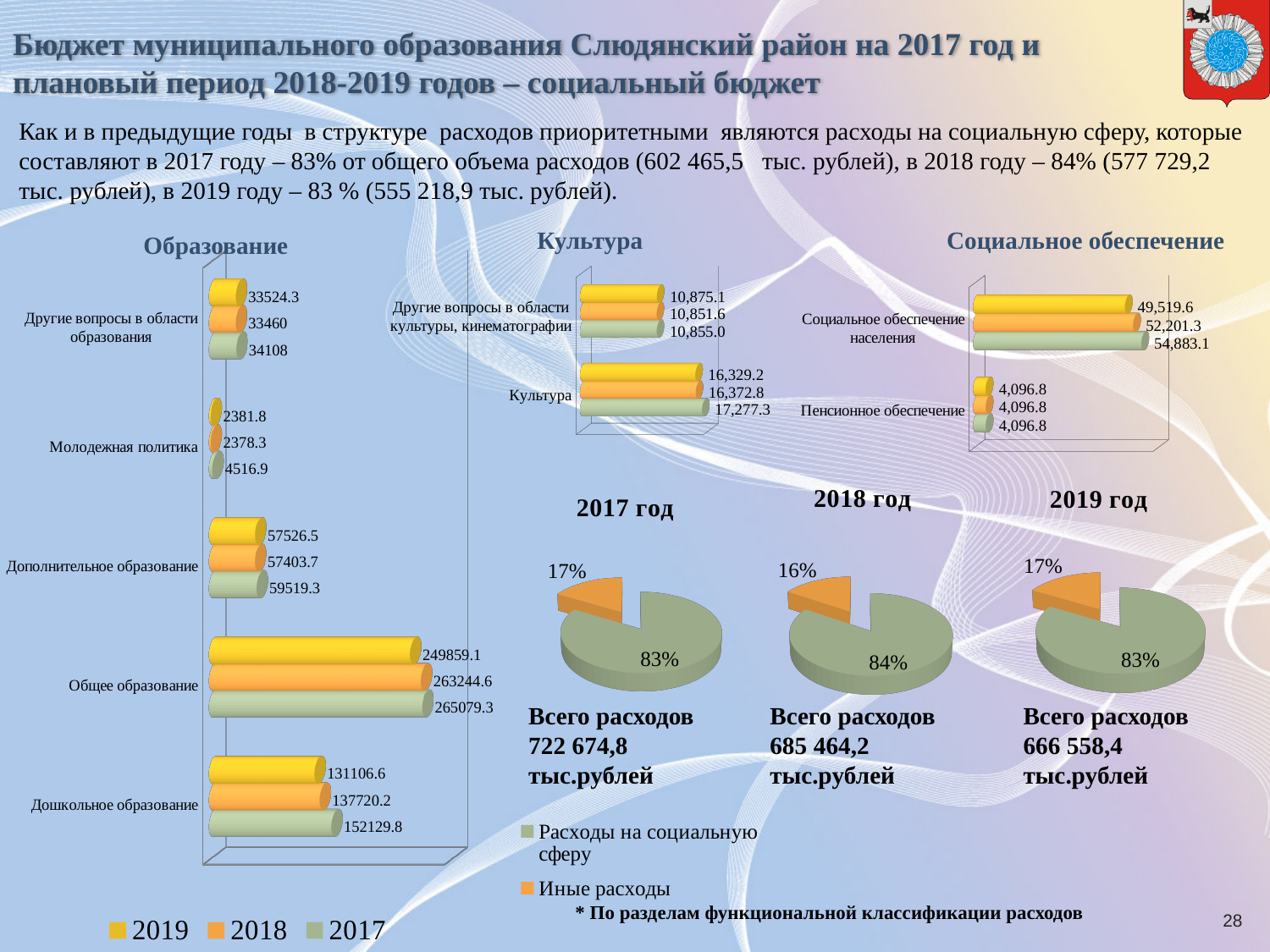
In the "2018 год" pie chart, what share is "Расходы на социальную сферу"? 84% In the "Образование" chart, what is the difference between the 2017 and 2019 values for "Дошкольное образование"? 21023.2 In the "Образование" chart, what is the value for "Общее образование" in 2017? 265079.3 In the "Образование" chart, which category has the lowest value in 2017? Молодежная политика In the "Образование" chart, what is the value for "Дошкольное образование" in 2019? 131106.6 What kind of chart is the "2017 год" chart? Pie chart In the "Культура" chart, what is the value for "Культура" in 2017? 17,277.3 How many series does the legend of the "Образование" chart list? 3 In the "Социальное обеспечение" chart, what is the value for "Социальное обеспечение населения" in 2018? 52,201.3 In the "Социальное обеспечение" chart, what is the value for "Пенсионное обеспечение" in 2019? 4,096.8 In the "Культура" chart, which is larger: the 2019 value for "Культура" or the 2019 value for "Другие вопросы в области культуры, кинематографии"? Культура In the "Образование" chart, which category has the highest value in 2018? Общее образование